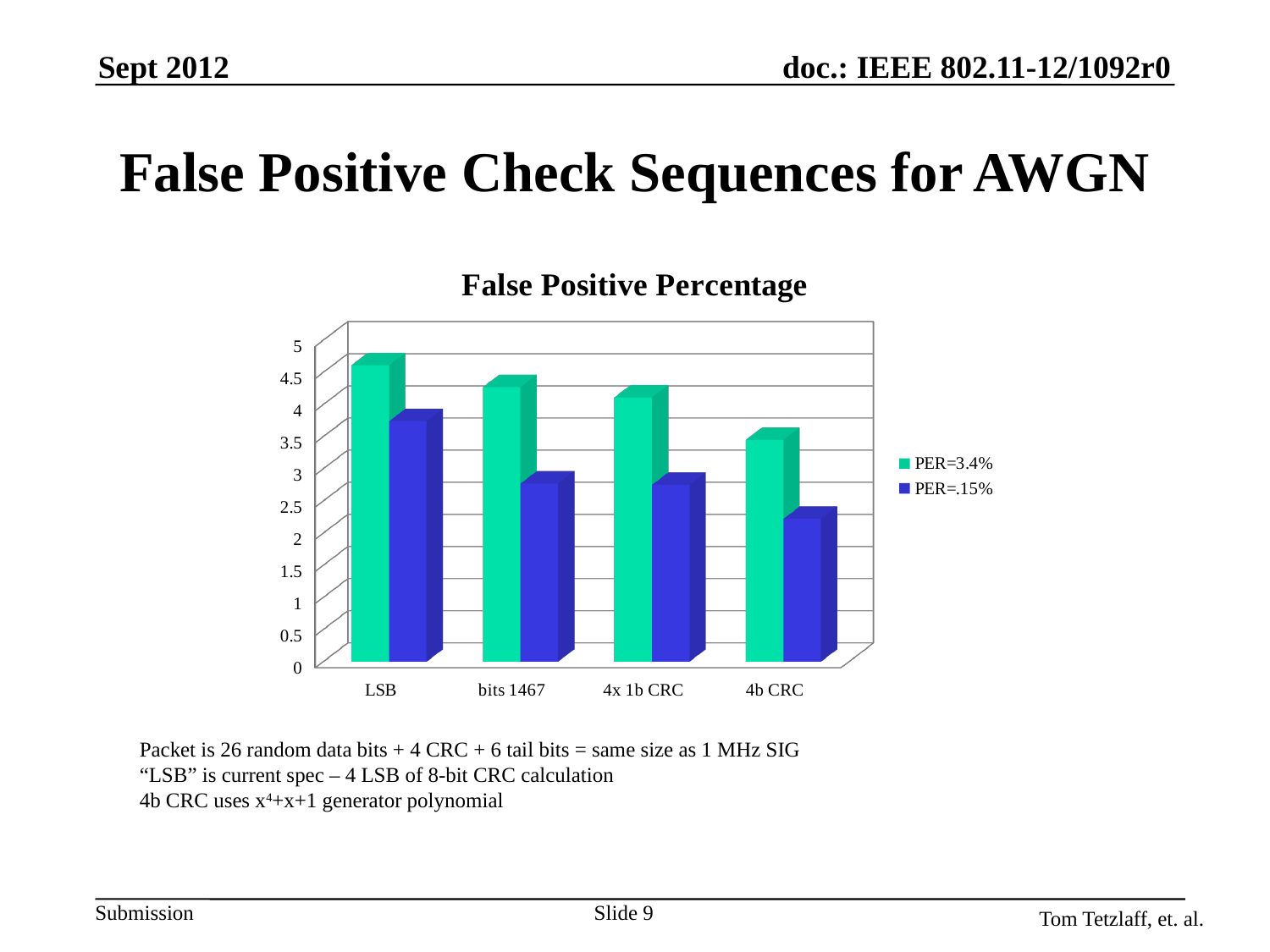
Is the PER=3.4% value for 4b CRC greater or less than 4? less Do the PER=3.4% values rise or fall from LSB to 4b CRC along the x axis? fall What is the title of the chart? False Positive Percentage Which category has the lowest value for the PER=3.4% series? 4b CRC Which category has the lowest value for the PER=.15% series? 4b CRC How many series does the legend list? 2 For the PER=.15% series, which is larger: LSB or 4b CRC? LSB How many categories are shown on the x axis? 4 Is the PER=3.4% value for LSB greater or less than 4? greater Which category has the highest value for the PER=3.4% series? LSB What type of chart is shown on the slide? bar chart Is the PER=.15% value for LSB greater or less than 3? greater